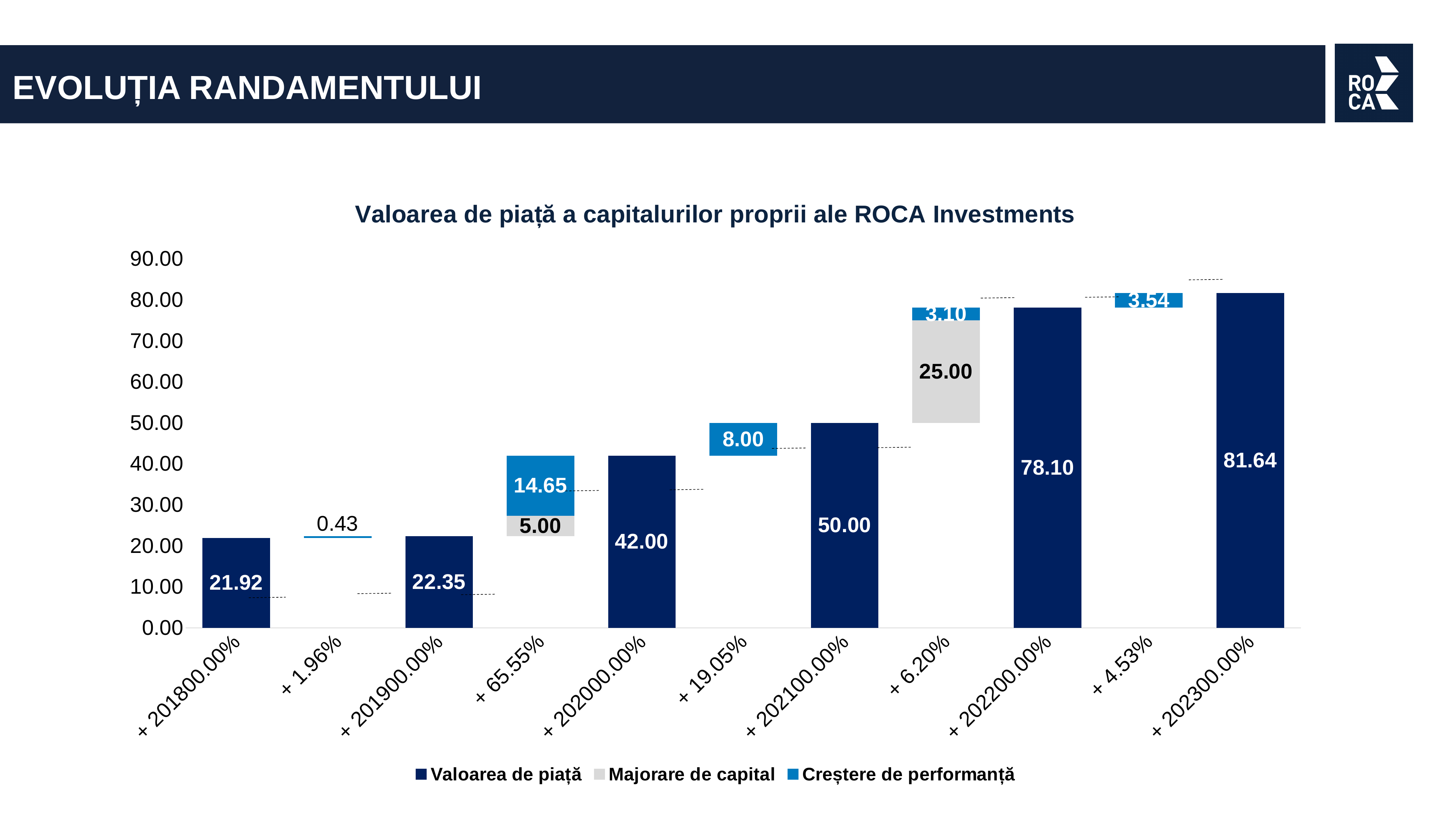
Do the Valoarea de piață bars rise or fall from left to right along the x axis? rise What is the Creștere de performanță value shown for the category labelled "+ 19.05%"? 8.00 Which category has the highest Valoarea de piață bar? + 202300.00% What is the value of the Valoarea de piață bar for the category labelled "+ 202300.00%"? 81.64 How many series does the legend list? 3 Which category has the lowest Valoarea de piață bar? + 201800.00% How many categories are shown on the x axis? 11 What is the value of the Valoarea de piață bar for the category labelled "+ 201800.00%"? 21.92 What is the difference between the Valoarea de piață values for "+ 202300.00%" and "+ 202200.00%"? 3.54 What is the Majorare de capital value shown for the category labelled "+ 6.20%"? 25.00 Which is larger, the Valoarea de piață value for "+ 202000.00%" or for "+ 202100.00%"? + 202100.00% What is the total of the stacked bar for the category labelled "+ 65.55%"? 19.65